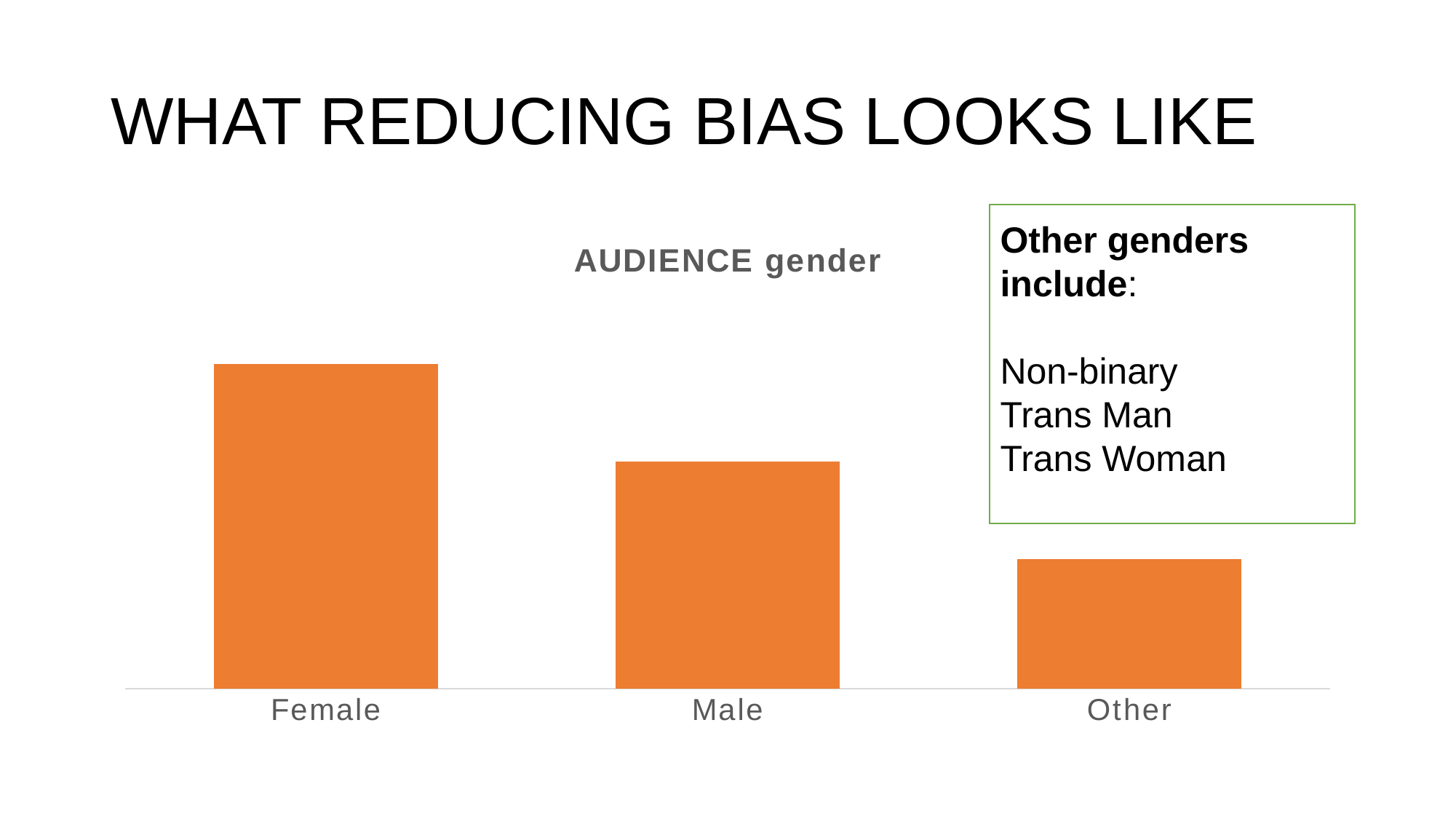
What is the label of the middle category on the x axis? Male Which bar is taller, Female or Male? Female Do the bar heights rise or fall from left to right across the x axis? fall Which bar is taller, Male or Other? Male What colour are the bars in the chart? orange What is the title of the chart? AUDIENCE gender Which category has the lowest bar in the chart? Other What kind of chart is shown on the slide? bar chart Which category has the highest bar in the chart? Female How many categories are shown on the x axis of the chart? 3